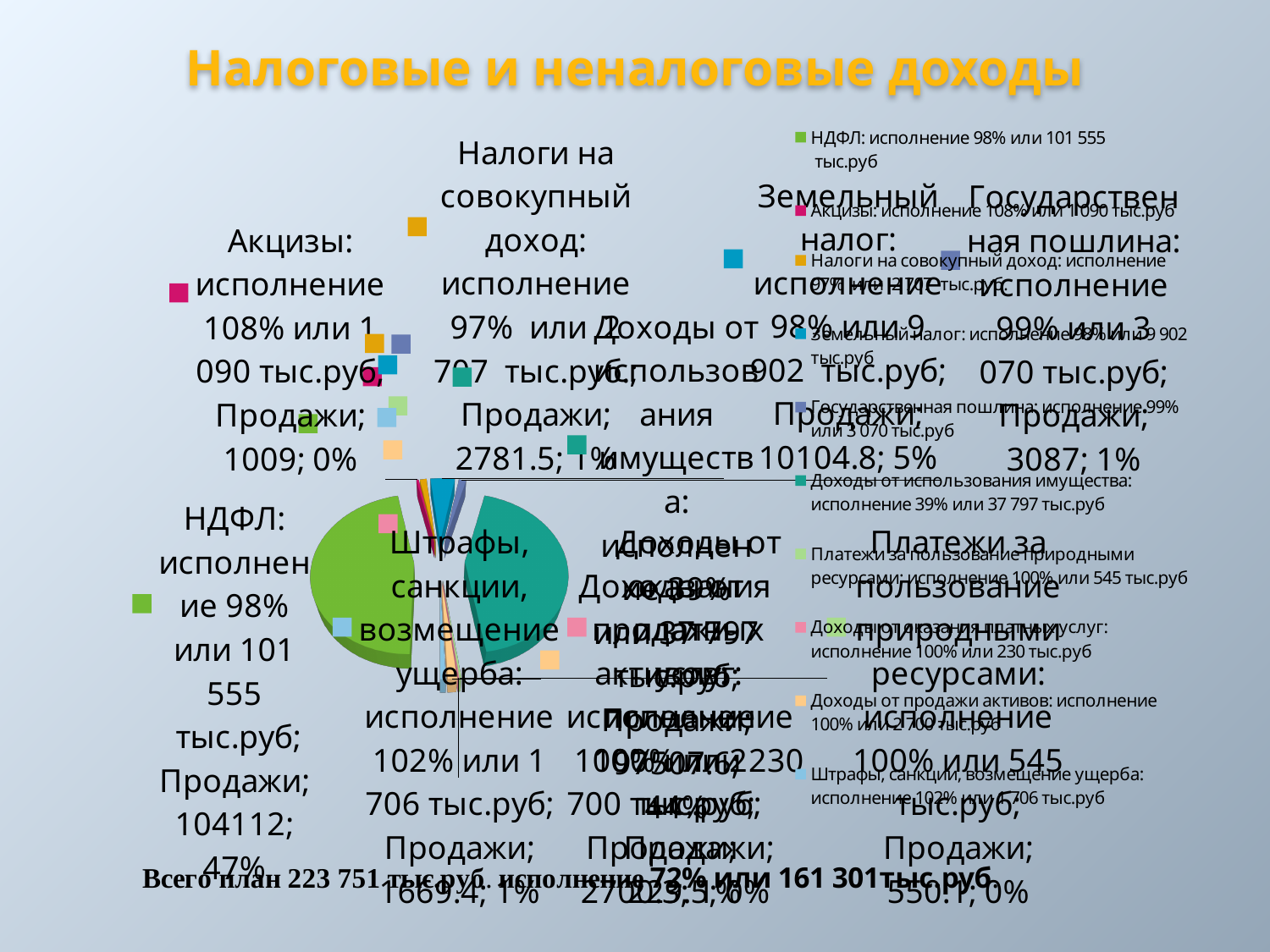
What value is labelled for the Акцизы slice? 1009 What value is labelled for the Земельный налог slice? 10104.8 What value is labelled for the Государственная пошлина slice? 3087 What value is labelled for the НДФЛ slice? 104112 What share of the pie does the Земельный налог slice represent? 5% What share of the pie does the НДФЛ slice represent? 47% What is the title of the slide? Налоговые и неналоговые доходы Which is larger, the value for Земельный налог or the value for Государственная пошлина? Земельный налог How many categories does the legend of the pie chart list? 10 Which category has the largest slice of the pie? НДФЛ What kind of chart is shown on the slide? pie chart What is the difference between the labelled values for Земельный налог and Государственная пошлина? 7017.8